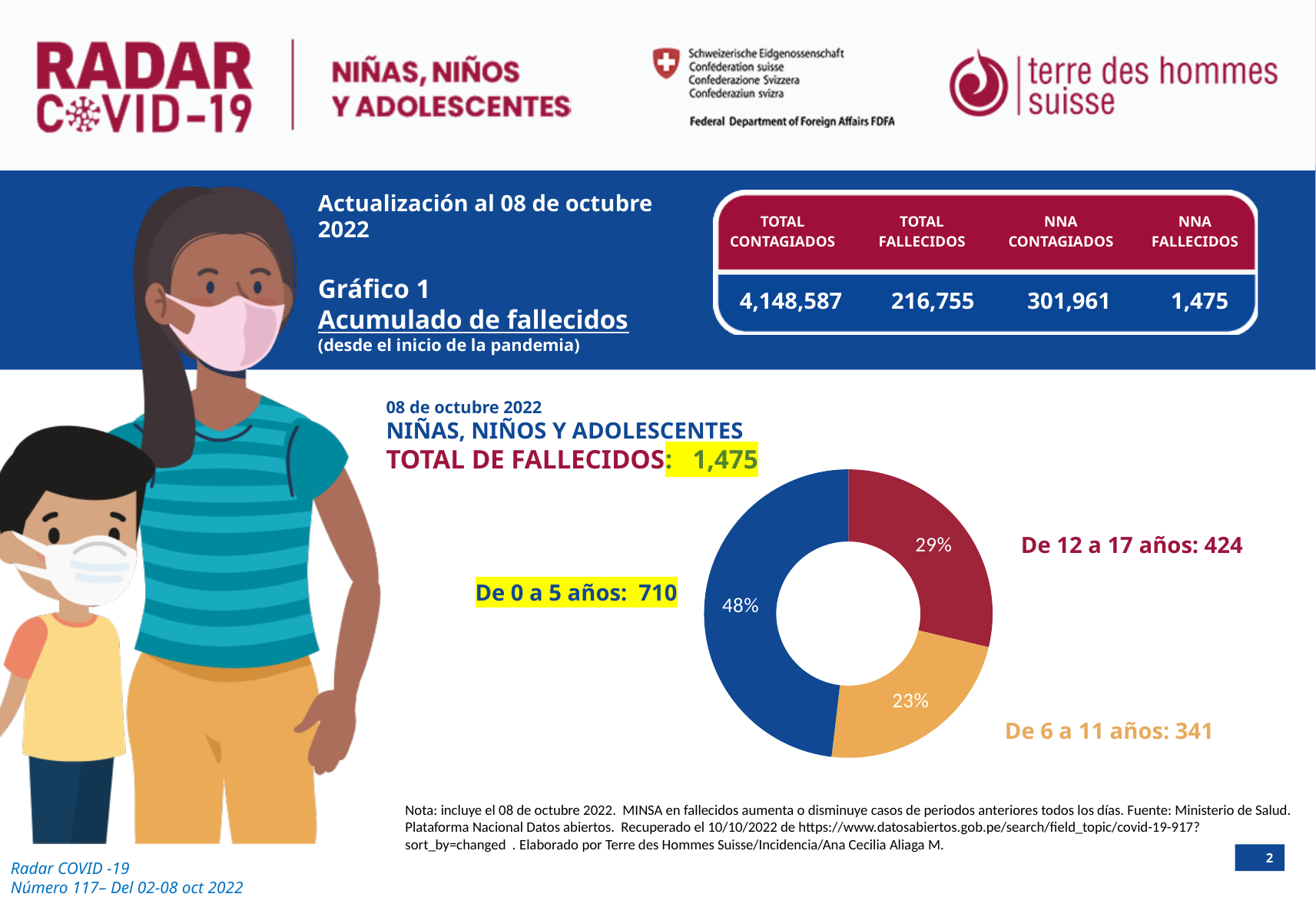
What is the number of deaths for the 'De 12 a 17 años' group? 424 What kind of chart is shown on the slide? Pie chart (doughnut) Which group has more deaths, 'De 6 a 11 años' or 'De 12 a 17 años'? De 12 a 17 años What is the total number of deaths shown for niñas, niños y adolescentes? 1,475 Which age group has the highest number of deaths? De 0 a 5 años What is the difference in deaths between the 'De 0 a 5 años' group and the 'De 12 a 17 años' group? 286 What percentage share of the pie does the 'De 6 a 11 años' group have? 23% What is the number of deaths for the 'De 0 a 5 años' group? 710 Which age group has the lowest number of deaths? De 6 a 11 años What percentage share of the pie does the 'De 0 a 5 años' group have? 48% What is the number of deaths for the 'De 6 a 11 años' group? 341 How many age groups does the pie chart show? 3